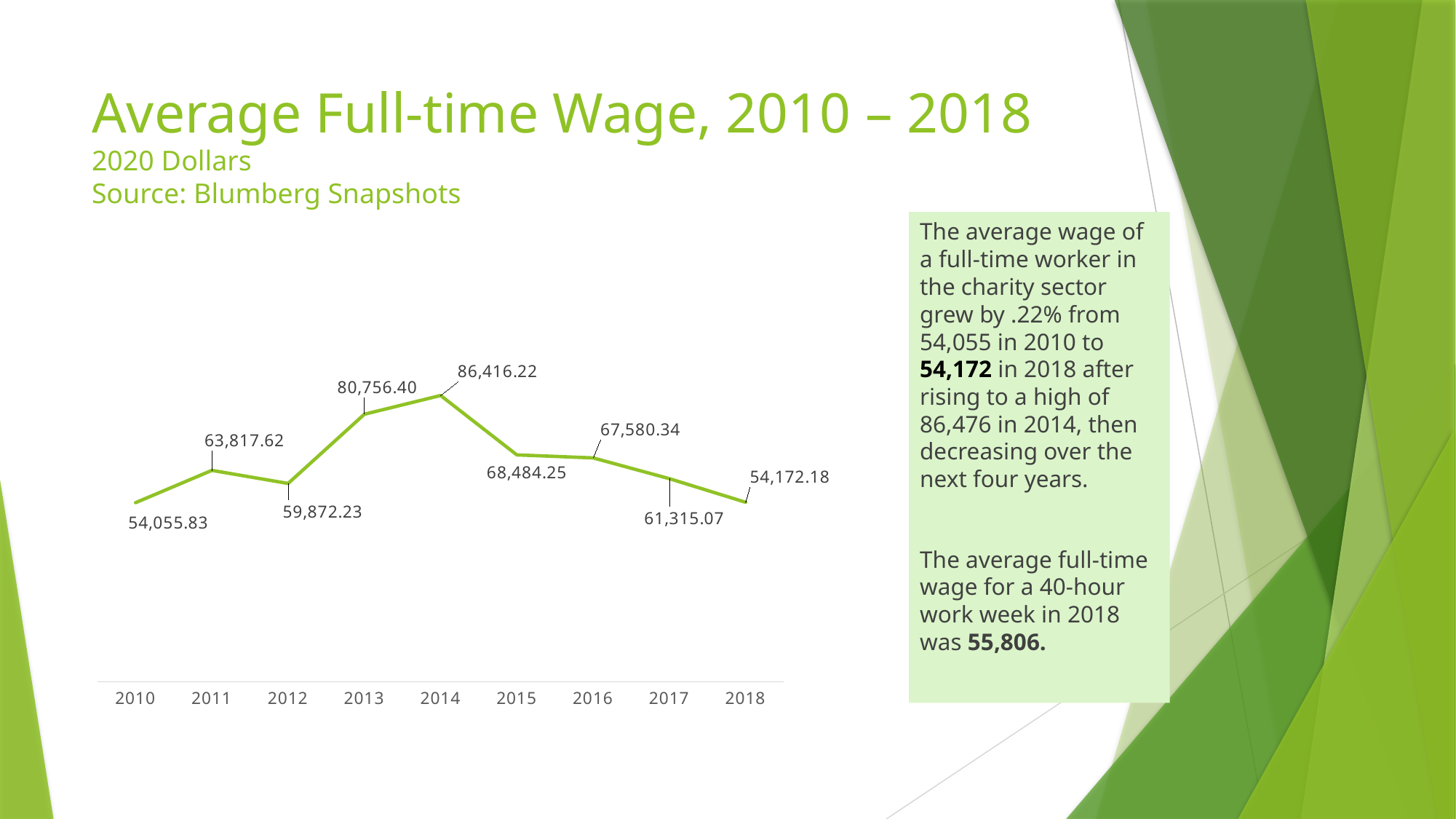
What is the difference between the 2014 value and the 2010 value? 32,360.39 Do the values rise or fall from 2014 to 2018? fall Which year has the highest average full-time wage? 2014 Which year has the larger value, 2015 or 2016? 2015 What type of chart is shown on the slide? line chart What is the average full-time wage shown for 2017? 61,315.07 What is the average full-time wage shown for 2012? 59,872.23 Which year has the lowest average full-time wage? 2010 How many years are plotted on the chart? 9 What is the average full-time wage shown for 2010? 54,055.83 What is the difference between the 2013 value and the 2012 value? 20,884.17 What is the average full-time wage shown for 2014? 86,416.22